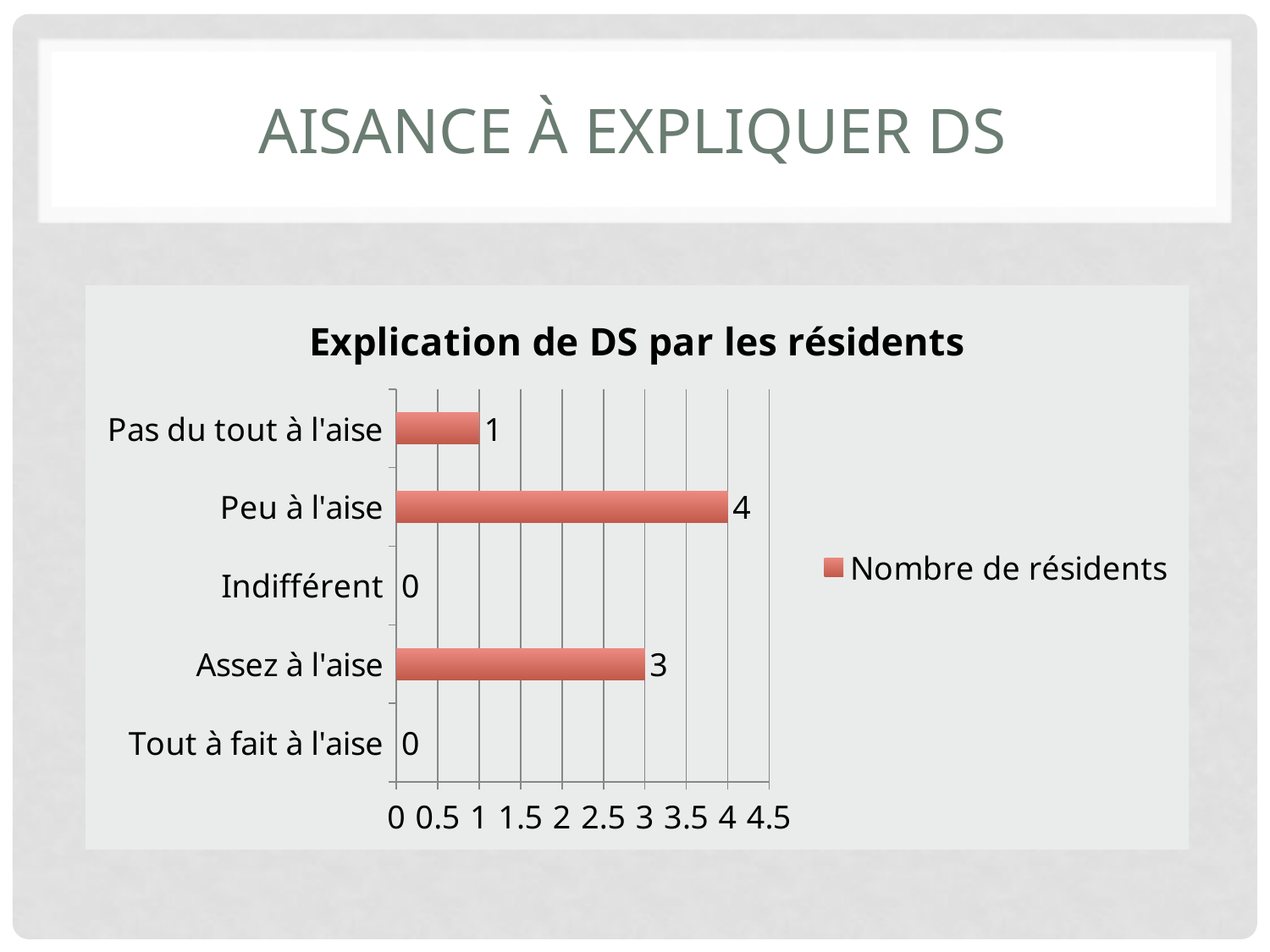
Which is larger, the value for "Assez à l'aise" or the value for "Pas du tout à l'aise"? Assez à l'aise What is the name of the series shown in the legend? Nombre de résidents What kind of chart is shown on the slide? Bar chart What is the difference between the values for "Peu à l'aise" and "Assez à l'aise"? 1 How many series does the legend list? 1 What is the title of the chart? Explication de DS par les résidents What is the value for "Tout à fait à l'aise"? 0 Which category has the highest value? Peu à l'aise What is the value for "Peu à l'aise"? 4 What is the value for "Pas du tout à l'aise"? 1 What is the value for "Assez à l'aise"? 3 How many categories are shown on the chart? 5